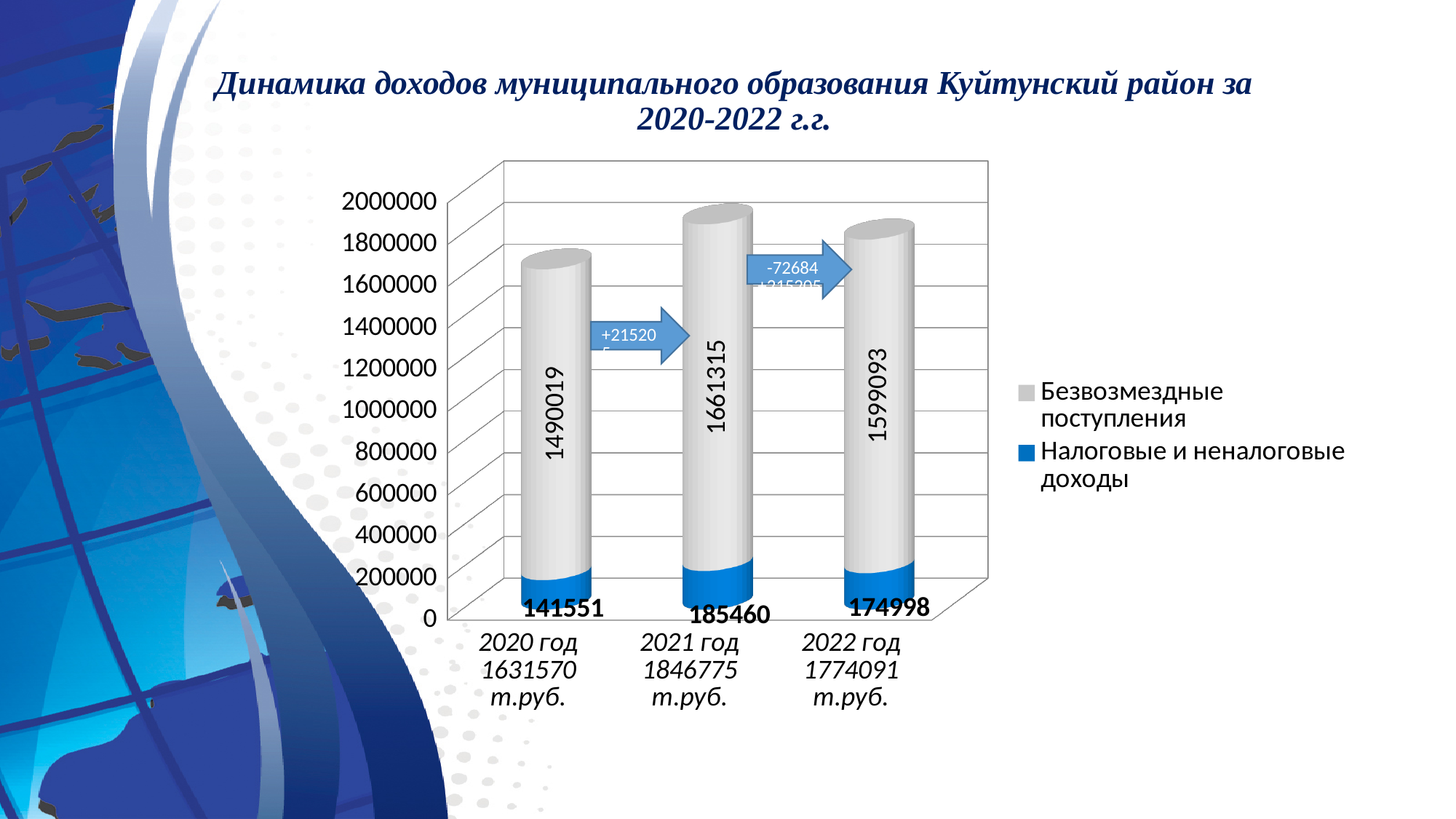
What is the total of the stacked bar for 2021 год? 1846775 Which year has the lowest value of Налоговые и неналоговые доходы? 2020 год What is the value of Безвозмездные поступления for 2020 год? 1490019 What kind of chart is shown on the slide? Stacked bar chart Which is larger: Налоговые и неналоговые доходы in 2021 год or in 2022 год? 2021 год What is the difference between Безвозмездные поступления in 2021 год and 2020 год? 171296 Which year has the highest value of Безвозмездные поступления? 2021 год How many years are shown on the x axis? 3 What is the value of Налоговые и неналоговые доходы for 2021 год? 185460 How many series does the legend list? 2 What is the value of Налоговые и неналоговые доходы for 2022 год? 174998 What is the value of Безвозмездные поступления for 2022 год? 1599093